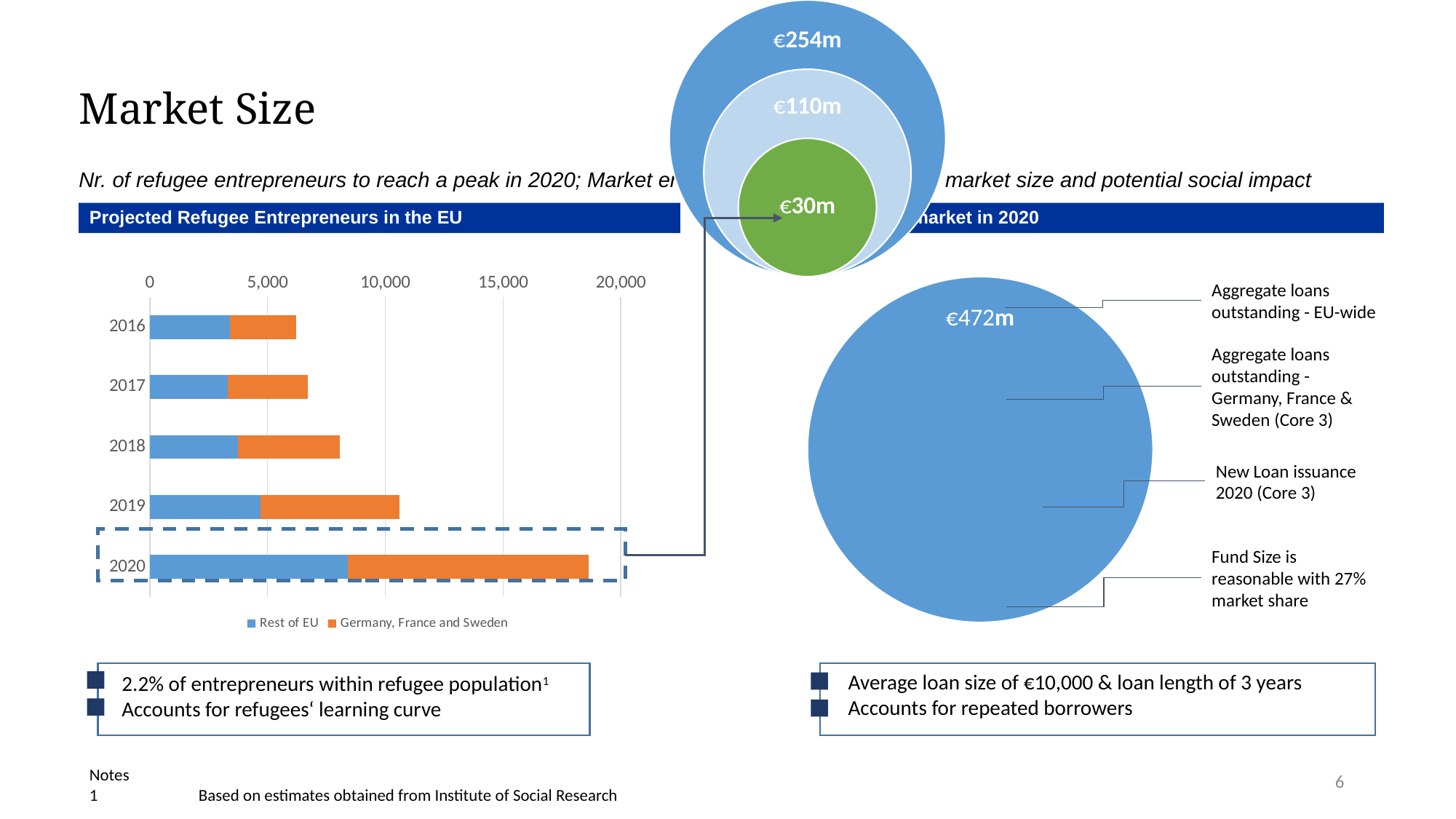
In the 'Projected Refugee Entrepreneurs in the EU' chart, is the 'Rest of EU' value for 2020 greater or less than 5,000? greater In the 'Projected Refugee Entrepreneurs in the EU' chart, do the total bar lengths rise or fall from 2016 to 2020? rise In the 'Projected Refugee Entrepreneurs in the EU' chart, is the total for 2019 greater or less than 10,000? greater In the 'Projected Refugee Entrepreneurs in the EU' chart, which segment is larger in 2020: 'Rest of EU' or 'Germany, France and Sweden'? Germany, France and Sweden In the circle diagram on the right, what value is shown for aggregate loans outstanding EU-wide (the largest circle)? €472m In the 'Projected Refugee Entrepreneurs in the EU' chart, which year has the highest total number of refugee entrepreneurs? 2020 How many series does the legend of the 'Projected Refugee Entrepreneurs in the EU' chart list? 2 In the 'Projected Refugee Entrepreneurs in the EU' chart, is the total for 2016 greater or less than 10,000? less What kind of chart is 'Projected Refugee Entrepreneurs in the EU'? Stacked bar chart How many years are shown on the 'Projected Refugee Entrepreneurs in the EU' chart? 5 What are the two legend entries of the 'Projected Refugee Entrepreneurs in the EU' chart? Rest of EU; Germany, France and Sweden